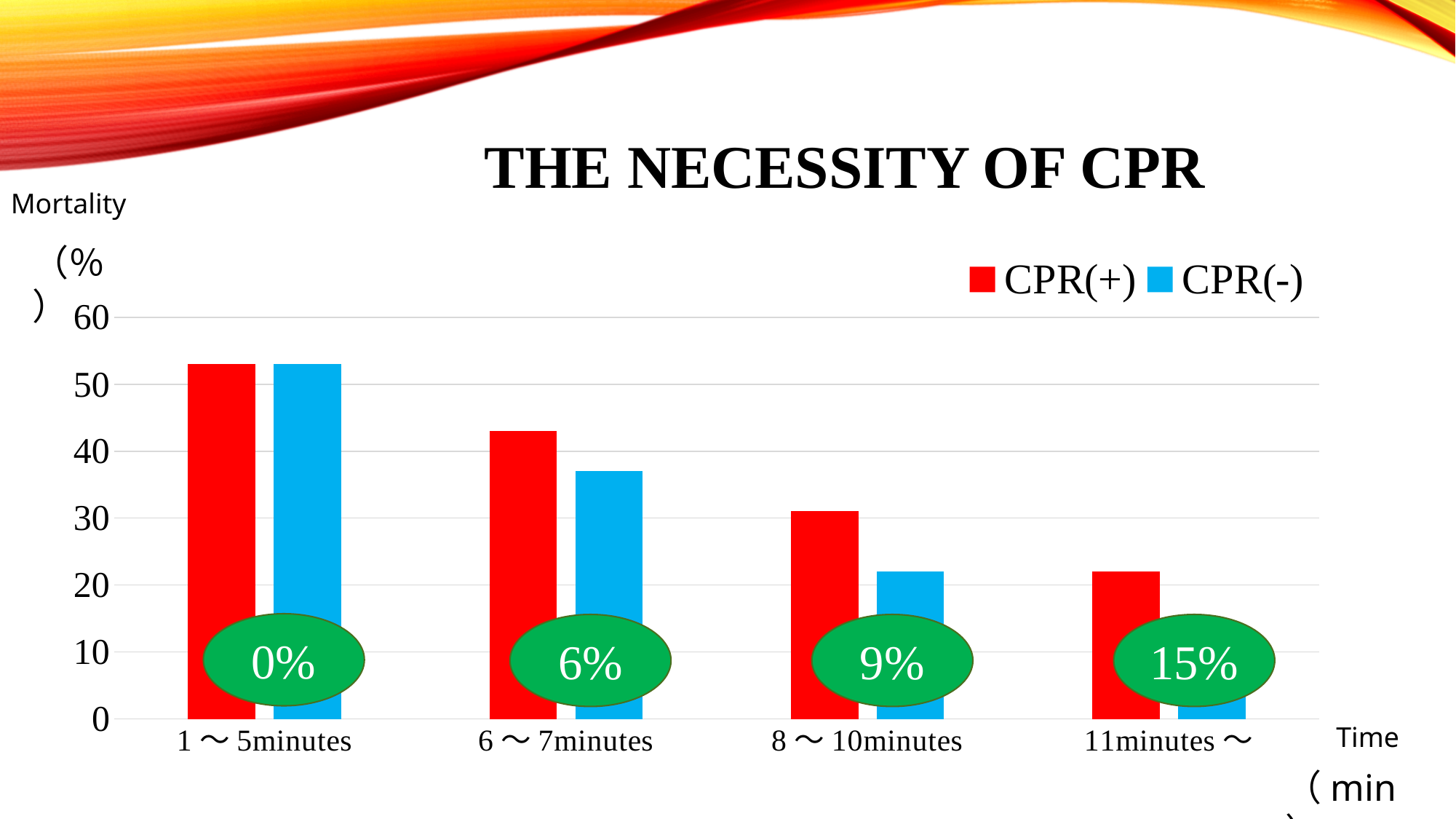
How many series does the legend list? 2 Do the CPR(+) values rise or fall as time increases along the x axis? fall How many time categories are shown on the x axis? 4 Is the CPR(+) value for 1～5minutes greater or less than 50? greater Is the CPR(-) value for 8～10minutes greater or less than 30? less What is the title of the chart? THE NECESSITY OF CPR Is the CPR(-) value for 6～7minutes greater or less than 40? less For 6～7minutes, which series has the larger value, CPR(+) or CPR(-)? CPR(+) What kind of chart is shown on the slide? bar chart For 8～10minutes, which series has the larger value, CPR(+) or CPR(-)? CPR(+) In which time category is the CPR(+) value highest? 1～5minutes